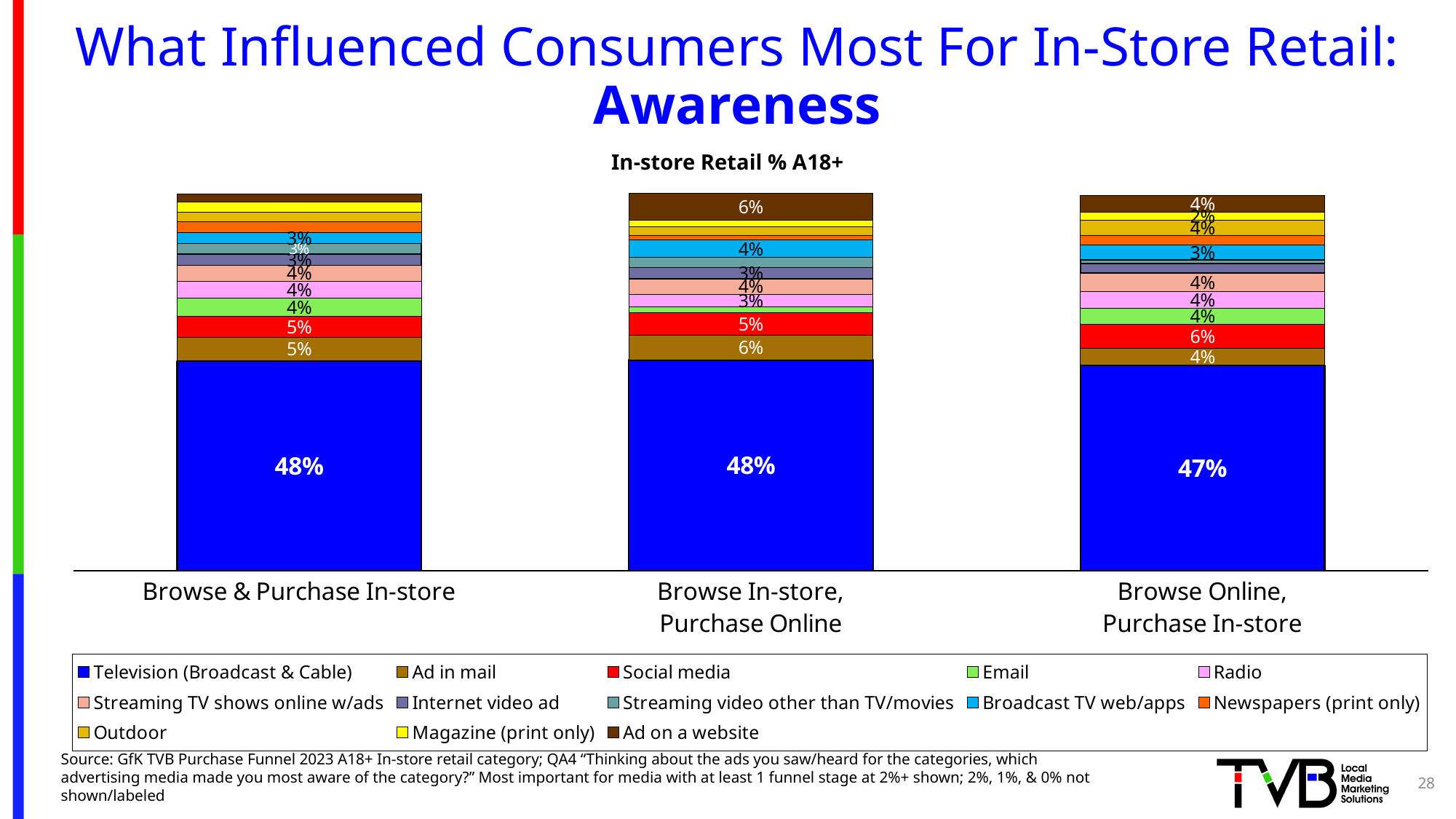
Which is larger for Browse In-store, Purchase Online: Ad in mail or Social media? Ad in mail What is the Television (Broadcast & Cable) value for Browse & Purchase In-store? 48% What is the Television (Broadcast & Cable) value for Browse Online, Purchase In-store? 47% What is the Magazine (print only) value for Browse Online, Purchase In-store? 2% What is the Ad on a website value for Browse In-store, Purchase Online? 6% Which category has the lowest Television (Broadcast & Cable) value? Browse Online, Purchase In-store How many series does the legend list? 13 What is the Social media value for Browse Online, Purchase In-store? 6% What kind of chart is shown on the slide? Stacked bar chart What is the Ad in mail value for Browse In-store, Purchase Online? 6% What is the difference between the Social media value and the Ad in mail value for Browse Online, Purchase In-store? 2% How many categories are shown on the x axis? 3